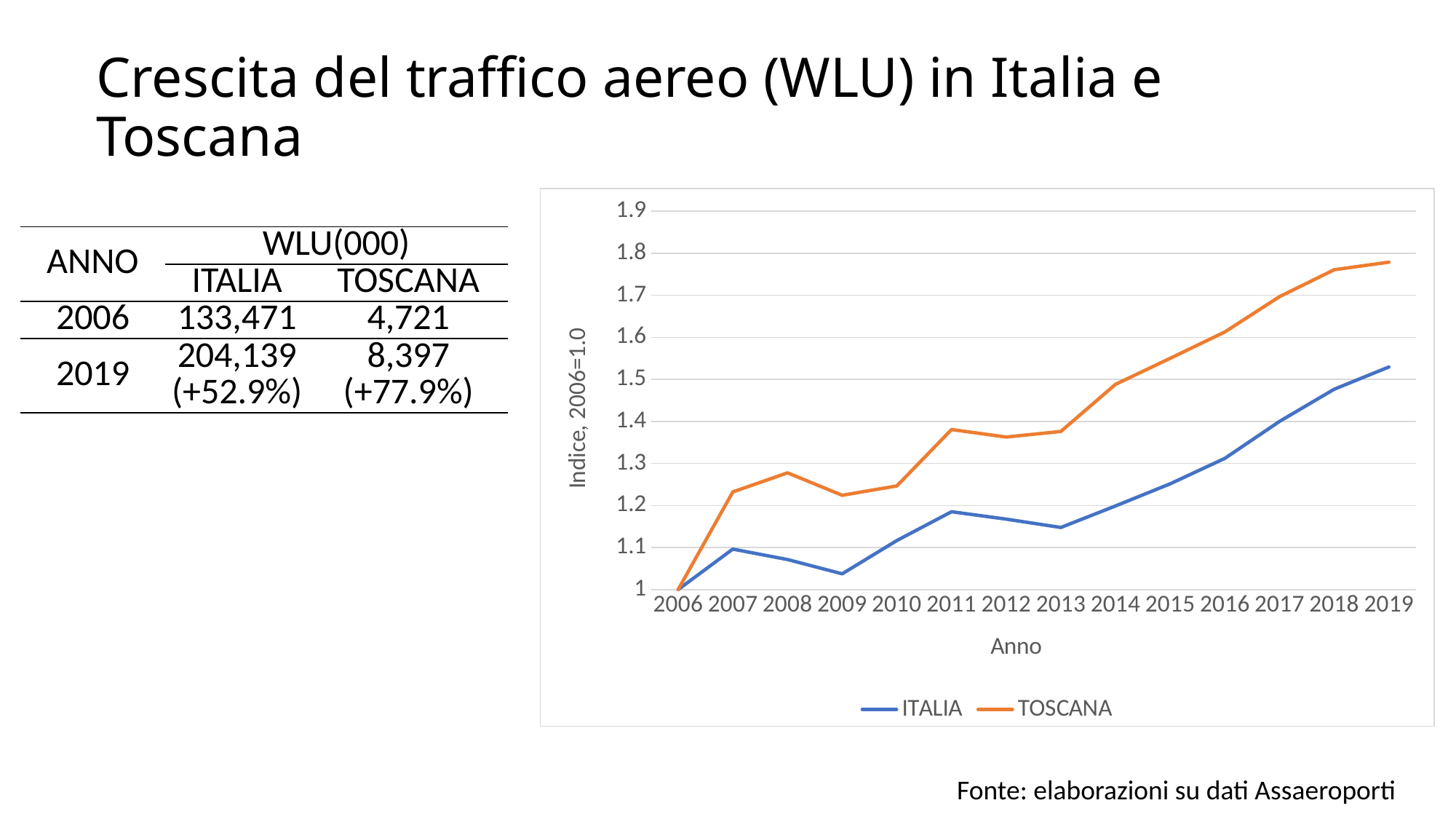
How many years are plotted along the x axis of the chart? 14 Is the value for TOSCANA in 2019 greater or less than 1.7? greater How many series does the chart legend list? 2 Is the value for ITALIA in 2013 greater or less than 1.2? less What is the title of the chart's vertical axis? Indice, 2006=1.0 Do the index values for TOSCANA generally rise or fall from 2006 to 2019? rise Is the value for ITALIA in 2017 greater or less than 1.5? less In which year is the ITALIA series at its lowest value? 2006 Which series has the higher index value in 2019, ITALIA or TOSCANA? TOSCANA In which year does the TOSCANA series reach its highest value? 2019 What kind of chart is shown on the slide? line chart What is the index value for ITALIA in 2006 on the chart? 1